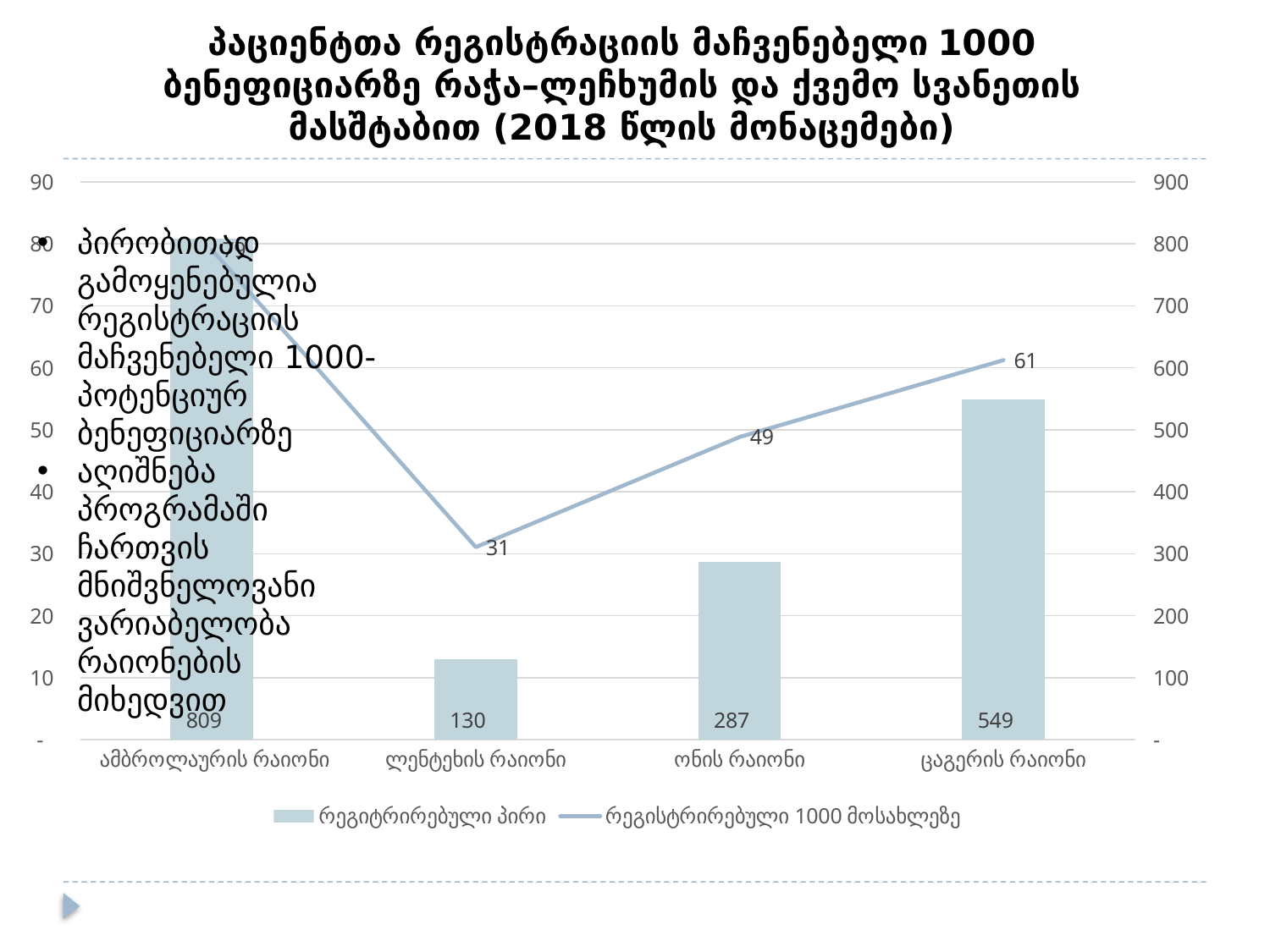
What kind of chart is shown on the slide? Combination bar and line chart What is the value of რეგიტრირებული პირი for ლენტეხის რაიონი? 130 How many categories are shown on the x axis? 4 How many series does the legend list? 2 Is the value of რეგიტრირებული პირი for ონის რაიონი greater or less than 300? less What is the value of რეგისტრირებული 1000 მოსახლეზე for ცაგერის რაიონი? 61 What is the value of რეგისტრირებული 1000 მოსახლეზე for ონის რაიონი? 49 Which category has the highest value of რეგიტრირებული პირი? ამბროლაურის რაიონი What is the difference in რეგიტრირებული პირი between ცაგერის რაიონი and ონის რაიონი? 262 What is the value of რეგიტრირებული პირი for ამბროლაურის რაიონი? 809 Which has a larger value of რეგისტრირებული 1000 მოსახლეზე, ლენტეხის რაიონი or ონის რაიონი? ონის რაიონი Which category has the lowest value of რეგიტრირებული პირი? ლენტეხის რაიონი